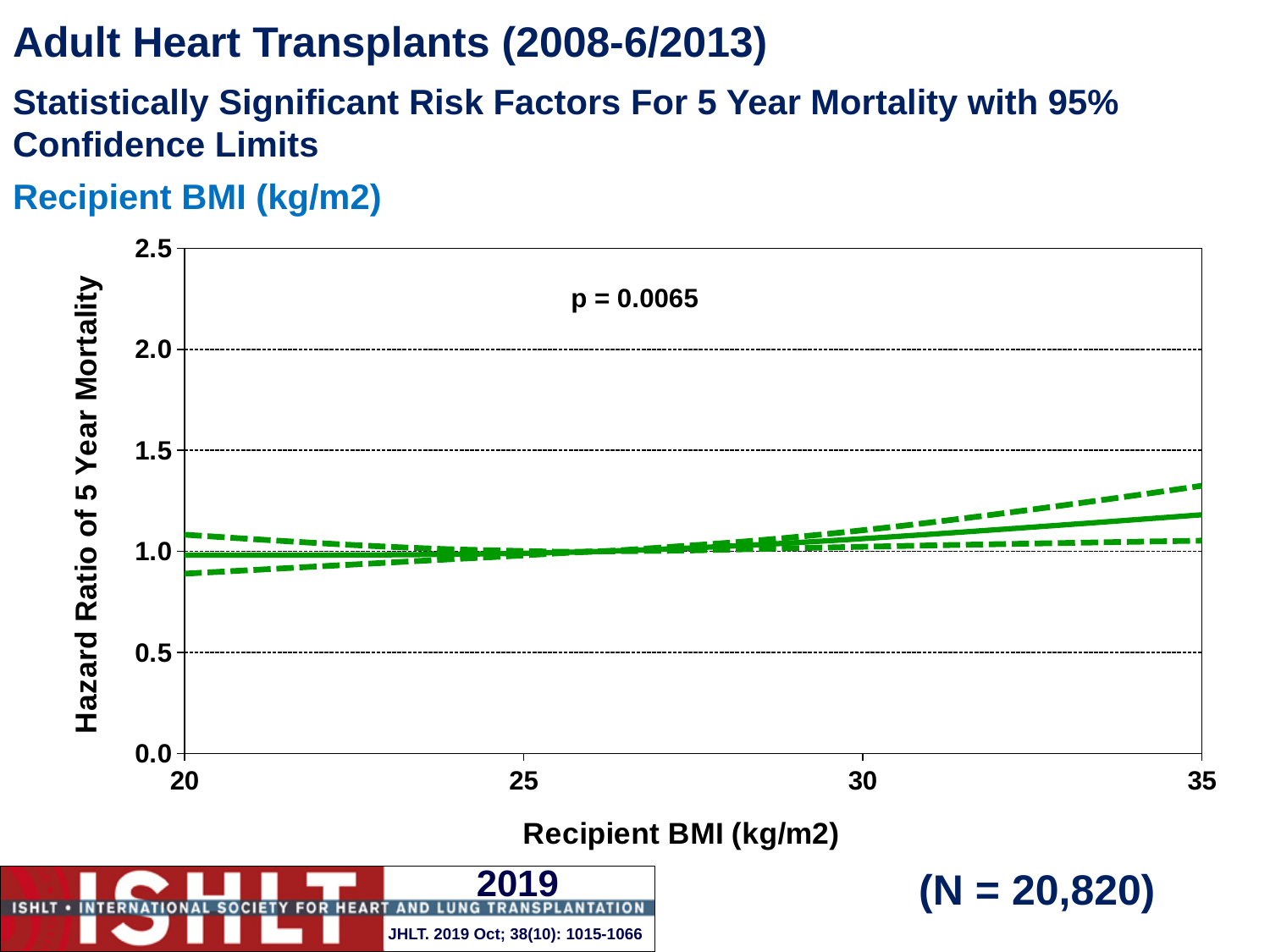
Does the hazard ratio of 5 year mortality rise or fall as recipient BMI increases from 25 to 35? rise What p-value is printed on the chart? p = 0.0065 What is the label of the y axis? Hazard Ratio of 5 Year Mortality Is the lower 95% confidence limit at a recipient BMI of 20 greater or less than 1.0? less Is the hazard ratio at a recipient BMI of 35 greater or less than 1.0? greater How many lines (solid and dashed) are plotted on the chart? 3 What kind of chart is shown on the slide? line chart What is the N (sample size) shown on the slide? N = 20,820 How many tick labels are shown on the x axis? 4 Is the hazard ratio at a recipient BMI of 35 greater or less than 1.5? less What is the label of the x axis? Recipient BMI (kg/m2)